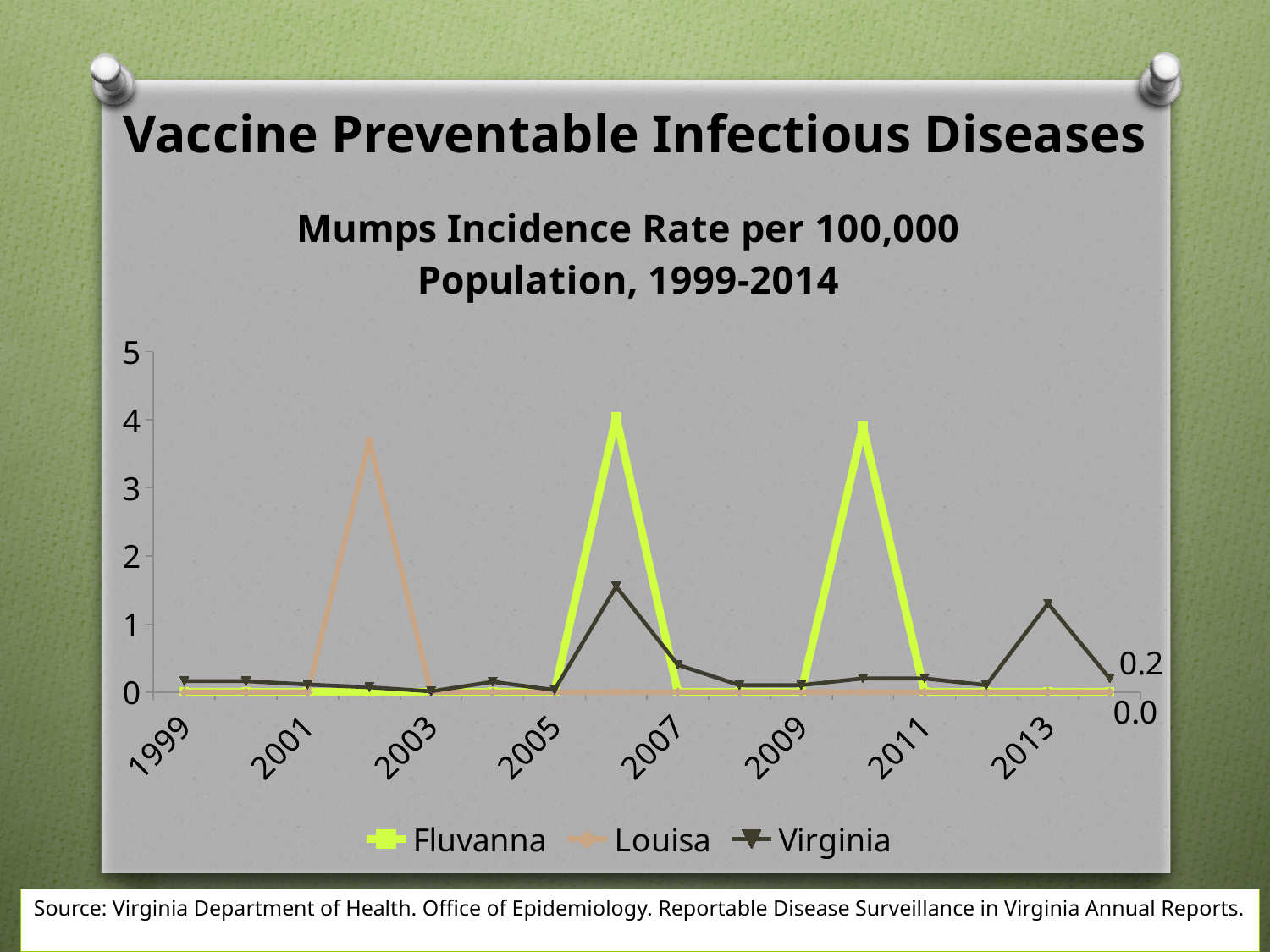
Is the Fluvanna value for 2010 greater or less than 3? greater Is the Virginia value for 2006 greater or less than 1? greater What is the title of the chart? Mumps Incidence Rate per 100,000 Population, 1999-2014 In which year does the Louisa series reach its highest value? 2002 In 2006, which series has the larger value, Fluvanna or Virginia? Fluvanna What is the Virginia value for 2014, as labelled on the chart? 0.2 In which year does the Virginia series reach its highest value? 2006 How many series does the legend list? 3 What kind of chart is shown on the slide? line chart Which series are listed in the chart legend? Fluvanna, Louisa, Virginia Is the Virginia value for 2006 greater or less than 2? less